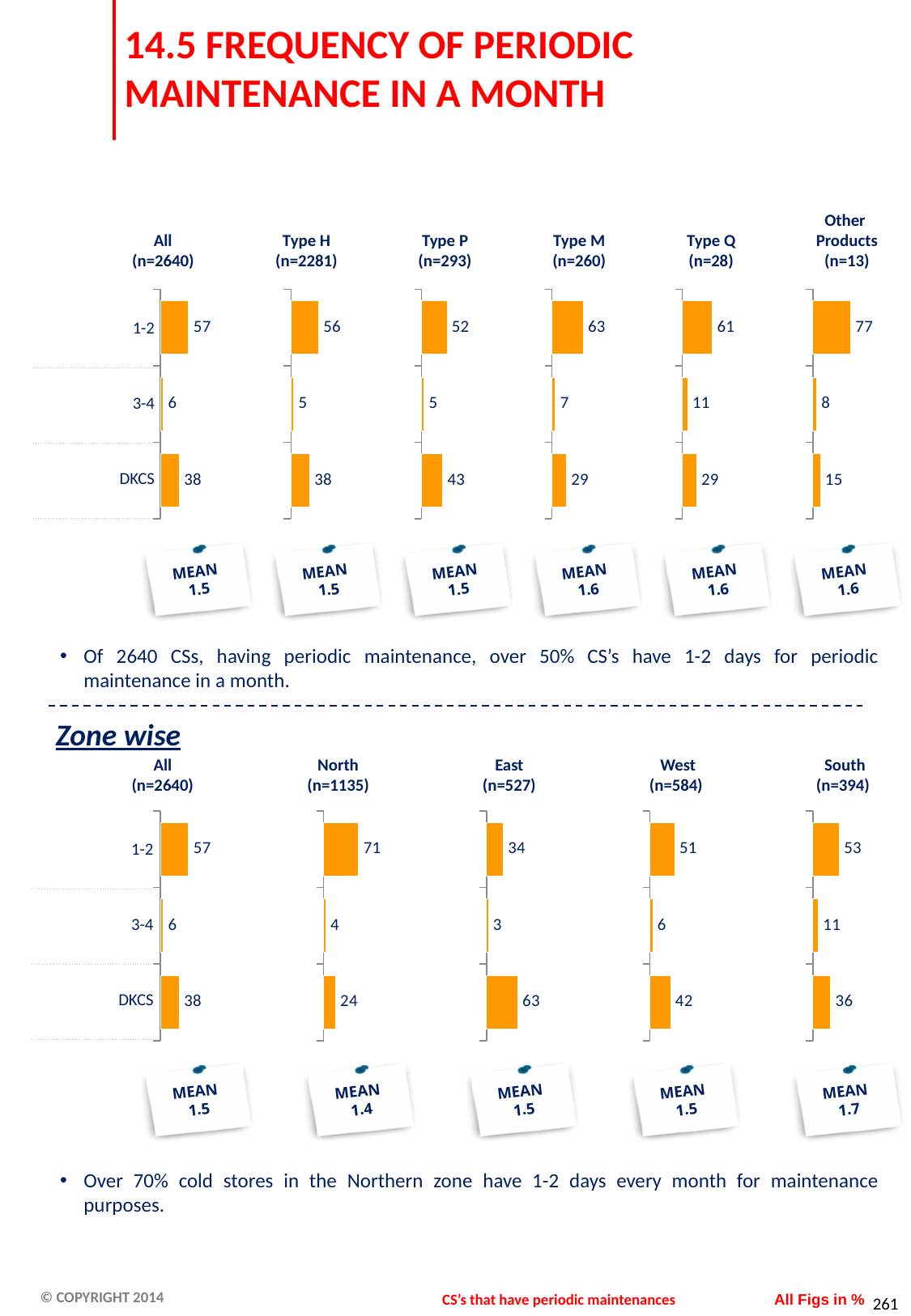
In the top row of charts (by product type), what is the value for 1-2 days in the Type M (n=260) chart? 63 In the Zone wise charts, which zone has the lowest value for 1-2 days? East In the Zone wise charts, what is the value for 1-2 days in the North (n=1135) chart? 71 In the top row of charts (by product type), which product type chart has the highest value for 1-2 days? Other Products In the Zone wise charts, what is the DKCS value in the East (n=527) chart? 63 In the top row of charts (by product type), what is the DKCS value in the Type P (n=293) chart? 43 How many categories are shown on the vertical axis of each chart in the Zone wise section? 3 In the Zone wise charts, is the 1-2 days value for West larger or the 1-2 days value for South? South What type of chart is used to show the frequency of periodic maintenance on this slide? Bar chart In the Zone wise charts, what is the difference between the DKCS values for East and North? 39 In the top row of charts (by product type), which chart has the lowest DKCS value? Other Products In the top row of charts (by product type), what is the difference between the 1-2 days value and the DKCS value in the All (n=2640) chart? 19